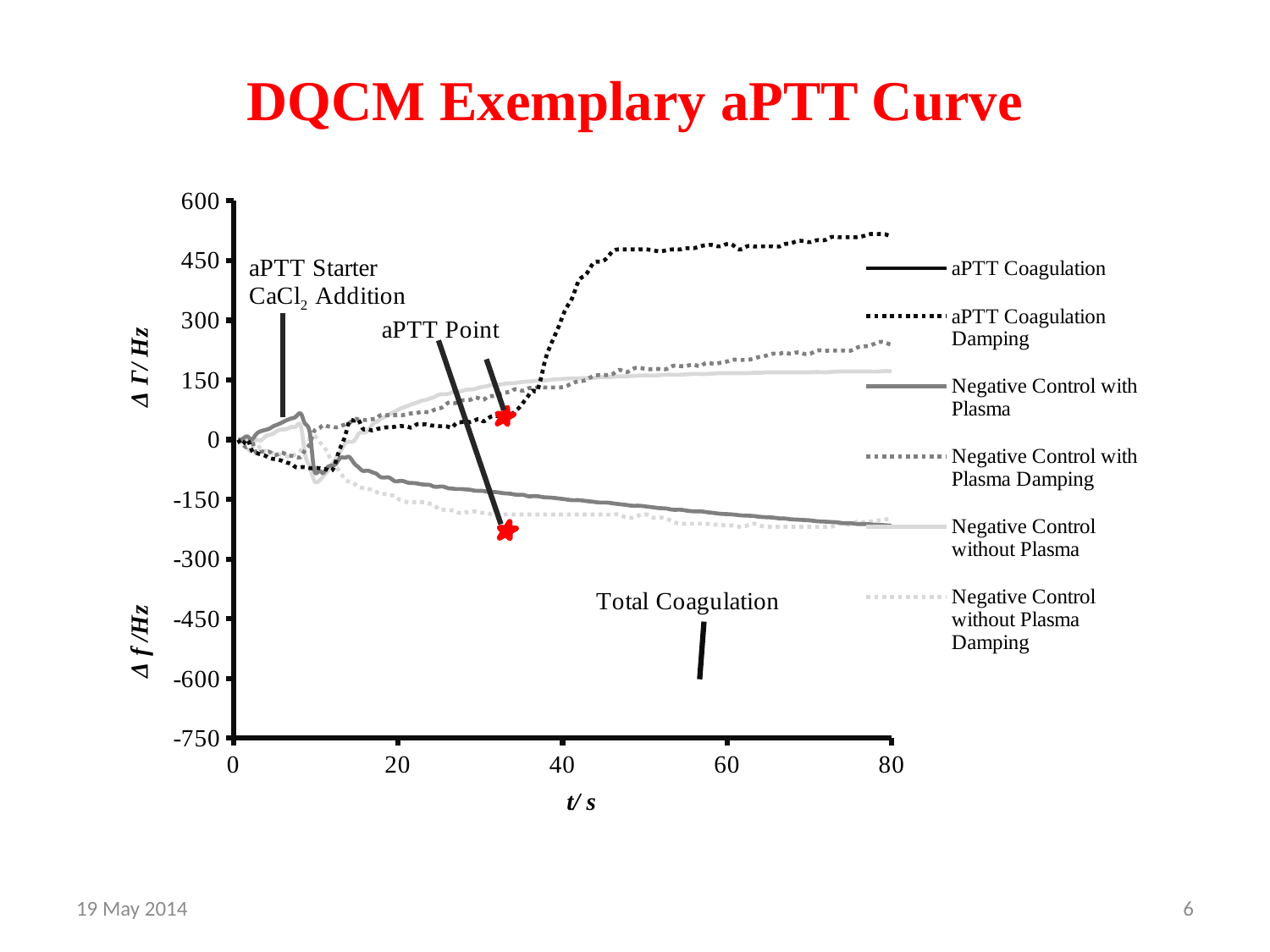
Does the aPTT Coagulation Damping series rise or fall between t = 20 s and t = 80 s? rise At t = 80 s, which is larger: aPTT Coagulation Damping or Negative Control with Plasma Damping? aPTT Coagulation Damping Which series has the highest value at t = 80 s? aPTT Coagulation Damping What is the title of the chart on the slide? DQCM Exemplary aPTT Curve Is the value of the Negative Control without Plasma Damping series at t = 80 s greater or less than -150? less Is the value of the aPTT Coagulation Damping series at t = 80 s greater or less than 450? greater How many series does the legend list? 6 What is the label of the x axis? t/ s What kind of chart is shown on the slide? Line chart Is the value of the Negative Control with Plasma Damping series at t = 80 s greater or less than 150? greater